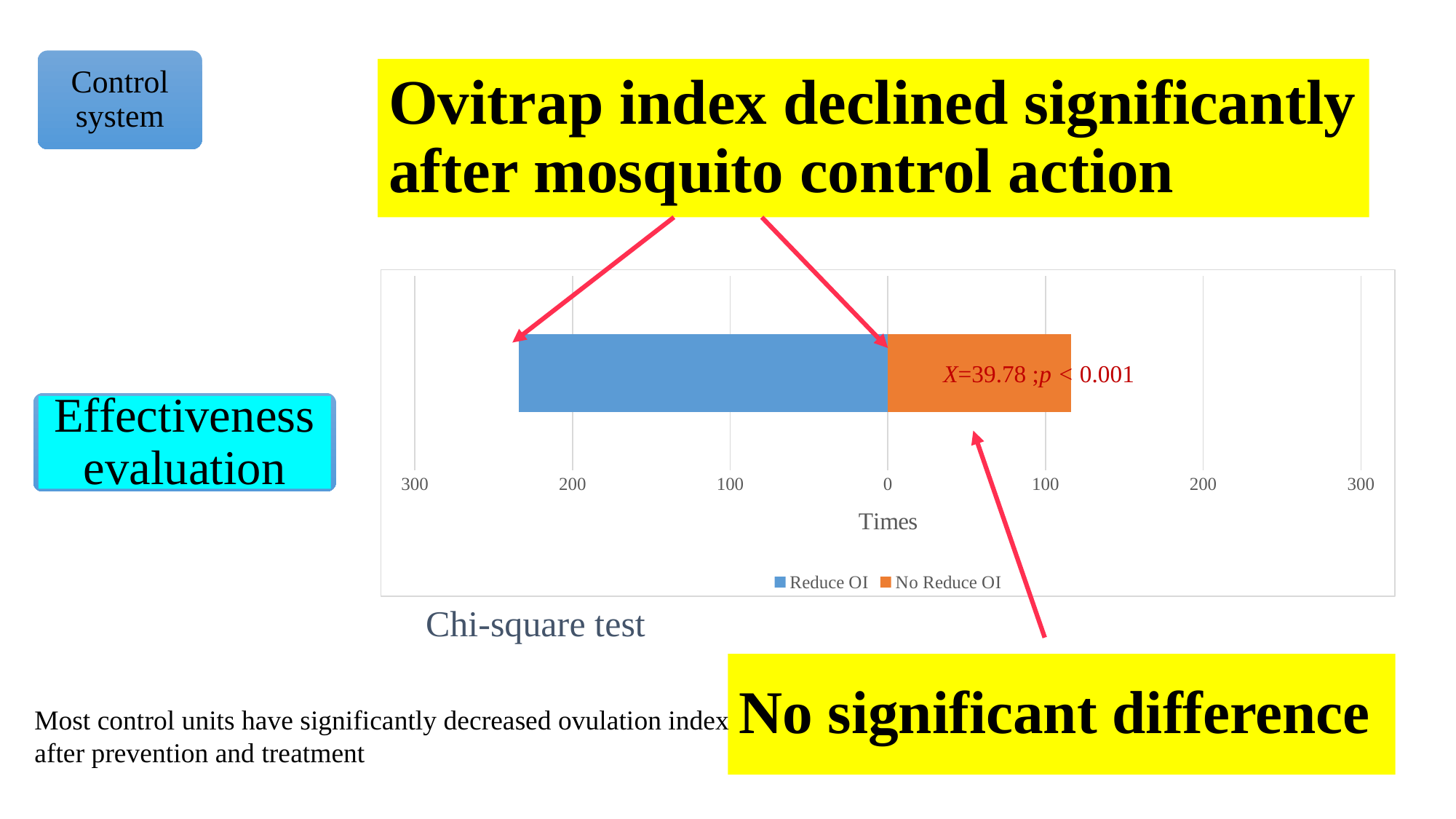
What are the two series named in the chart's legend? Reduce OI and No Reduce OI Is the value for No Reduce OI greater or less than 100? greater Is the value for Reduce OI greater or less than 200? greater Which colour represents the No Reduce OI series in the chart? orange Is the value for No Reduce OI greater or less than 200? less How many series does the chart's legend list? 2 What is the highest tick value shown on the chart's horizontal axis? 300 What kind of chart is shown on the slide? bar chart Which series has the lowest value in the chart? No Reduce OI Which series has the larger value, Reduce OI or No Reduce OI? Reduce OI Which series has the highest value in the chart? Reduce OI